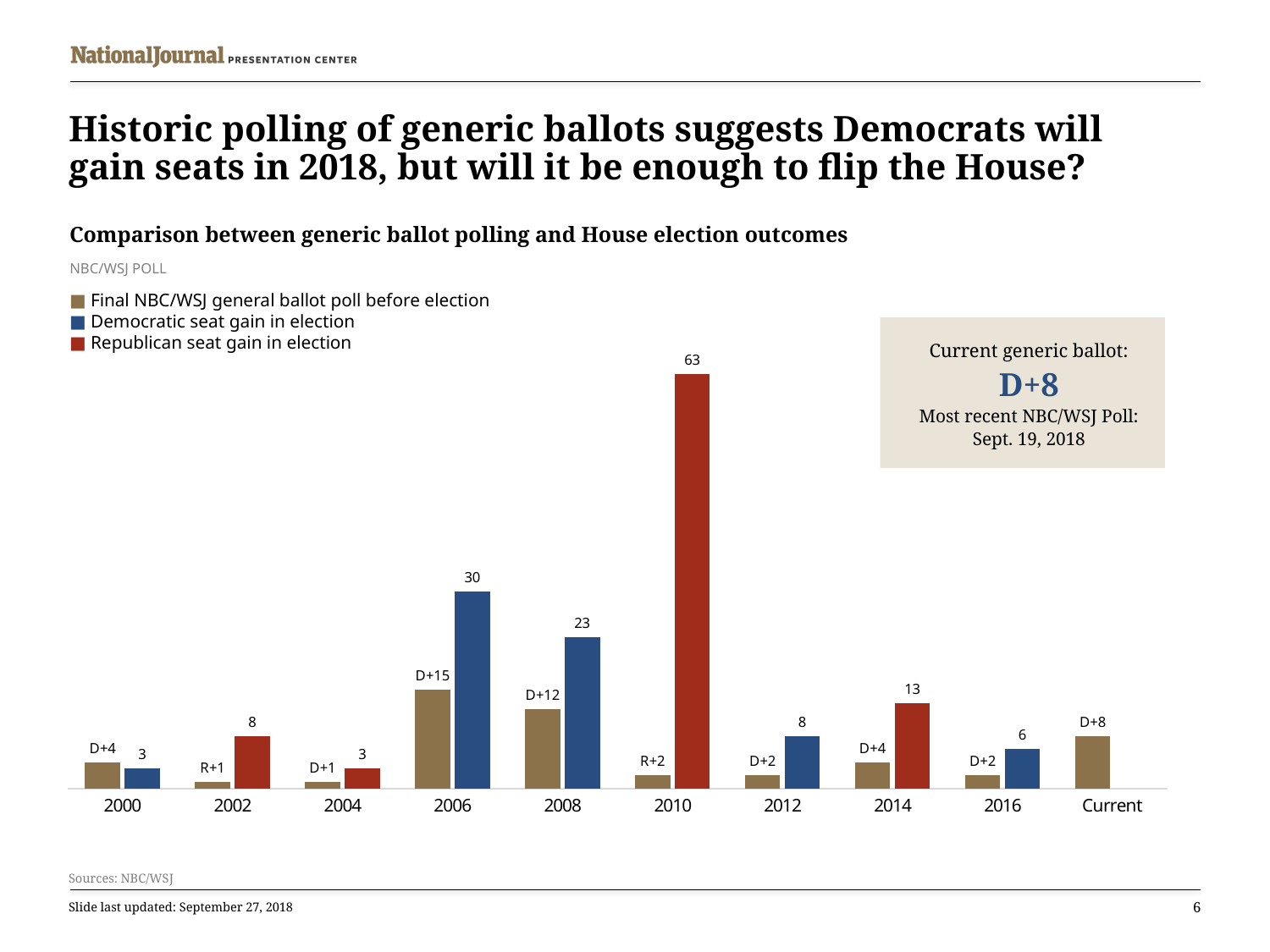
How many series does the legend list? 3 In which year was the Democratic seat gain the largest? 2006 Which was larger: the Republican seat gain in 2014 or the Democratic seat gain in 2012? Republican seat gain in 2014 What was the Democratic seat gain in the 2008 election? 23 What was the final NBC/WSJ generic ballot poll before the 2006 election? D+15 What is the value shown for the Current generic ballot poll? D+8 How many categories are shown along the x axis? 10 Which colour represents the Democratic seat gain in election? Blue In which year was the Republican seat gain the largest? 2010 What is the difference between the Democratic seat gain in 2006 and in 2008? 7 What was the Republican seat gain in the 2010 election? 63 What kind of chart is shown on the slide? Bar chart